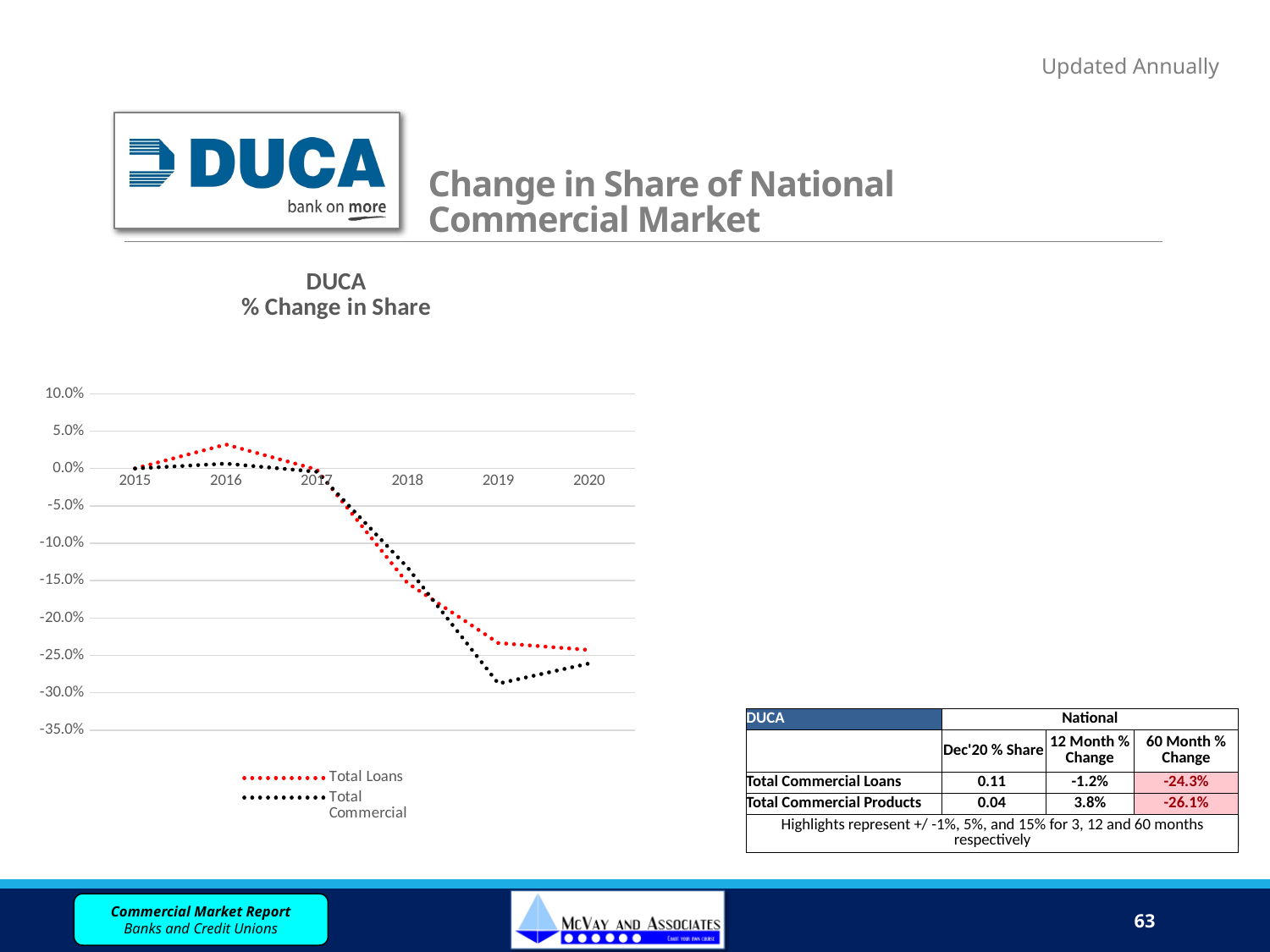
What is the title of the chart? DUCA % Change in Share How many years are plotted along the x axis of the chart? 6 What kind of chart is shown on the slide? line chart In which year does the Total Loans series reach its highest value? 2016 How many series does the legend of the chart list? 2 Is the value for Total Loans in 2016 greater or less than 0.0%? greater Is the value for Total Loans in 2018 greater or less than -10.0%? less Is the value for Total Commercial in 2019 greater or less than -25.0%? less In which year does the Total Commercial series reach its lowest value? 2019 Which series in the chart is drawn in red? Total Loans In 2019, which series has the higher value, Total Loans or Total Commercial? Total Loans